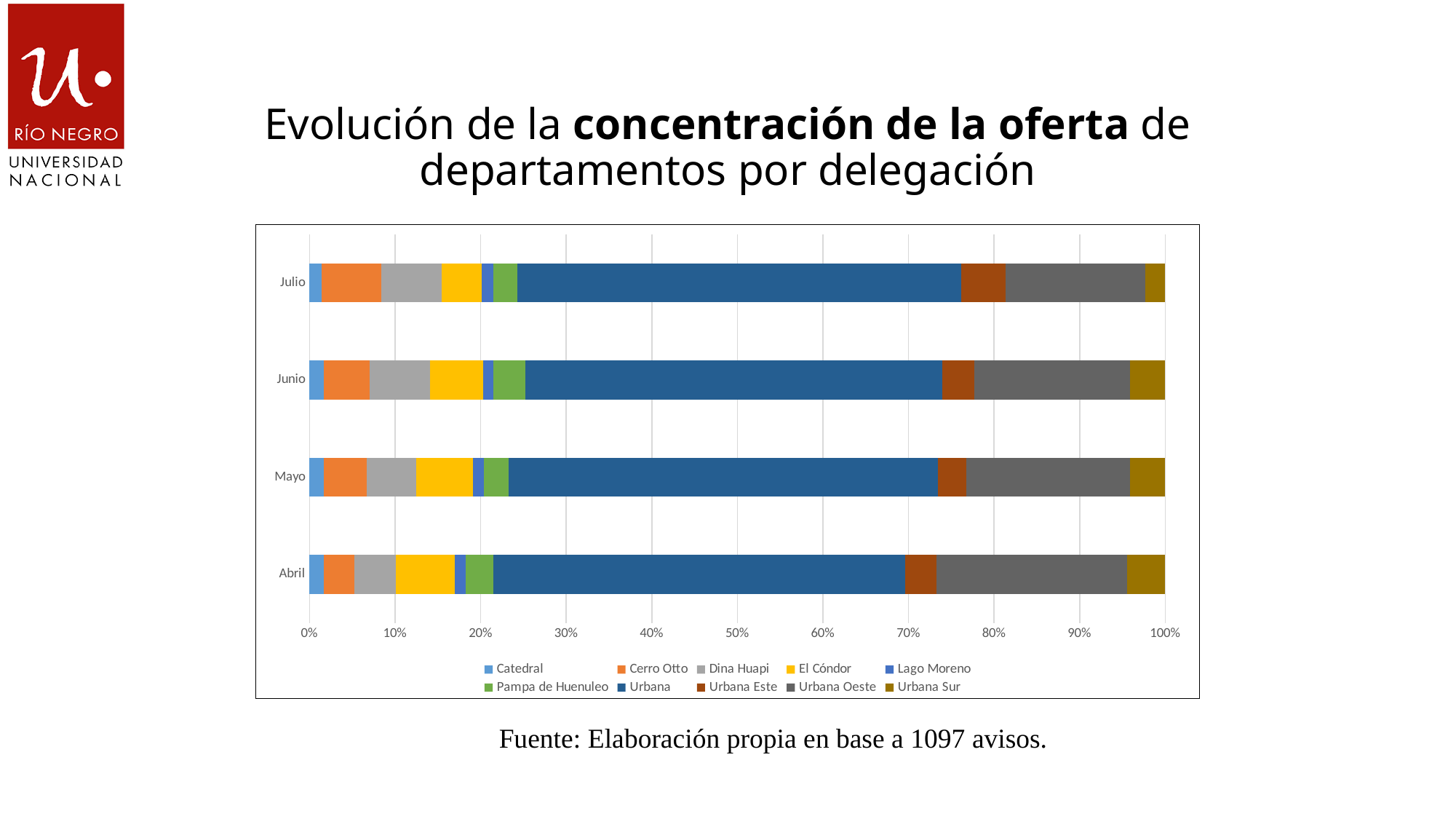
In Abril, which is larger: the Catedral segment or the Cerro Otto segment? Cerro Otto What is the highest value shown on the x axis of the chart? 100% Is the share for Urbana Oeste in Abril greater or less than 10%? greater Is the share for Urbana in Julio greater or less than 40%? greater Is the share for Catedral in Julio greater or less than 10%? less How many series does the chart's legend list? 10 What kind of chart is shown on the slide? Stacked bar chart How many months (categories) are shown on the y axis of the chart? 4 In Julio, which is larger: the Urbana segment or the Urbana Oeste segment? Urbana Which delegación has the largest share of the bar for Julio? Urbana Which month is listed at the top of the chart? Julio